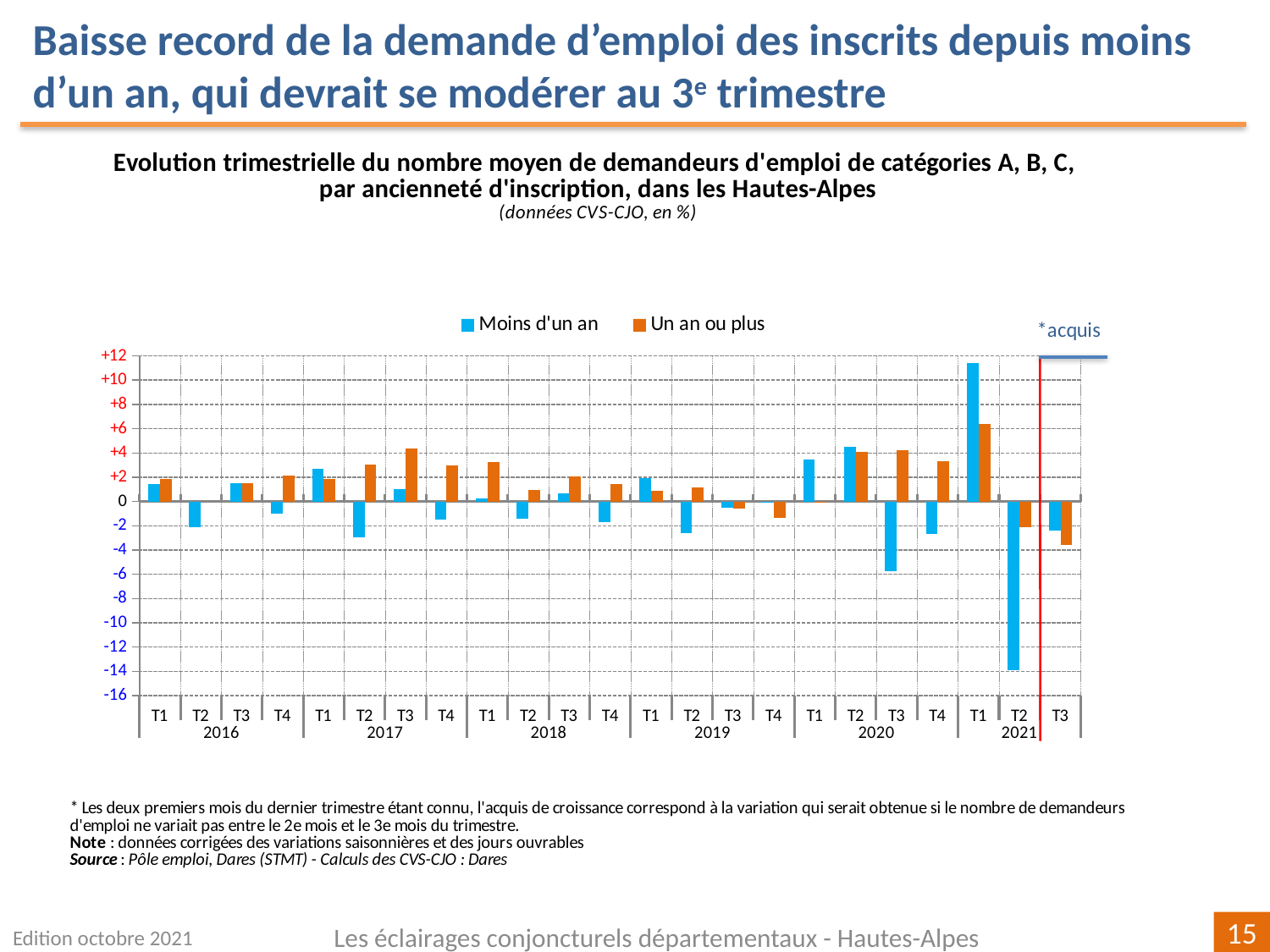
Is the value for 'Moins d'un an' in T2 2021 greater or less than -10? less Is the value for 'Un an ou plus' in T3 2017 greater or less than +4? greater In which quarter is the value for 'Moins d'un an' the lowest? T2 2021 In which quarter is the value for 'Moins d'un an' the highest? T1 2021 Is the value for 'Moins d'un an' in T1 2021 greater or less than +10? greater In T1 2021, which series has the larger value, 'Moins d'un an' or 'Un an ou plus'? Moins d'un an In which quarter is the value for 'Un an ou plus' the highest? T1 2021 What are the two series named in the legend? Moins d'un an; Un an ou plus How many series does the legend list? 2 What kind of chart is shown on the slide? bar chart How many quarters are plotted along the x axis? 23 In T3 2020, which series has the larger value, 'Moins d'un an' or 'Un an ou plus'? Un an ou plus